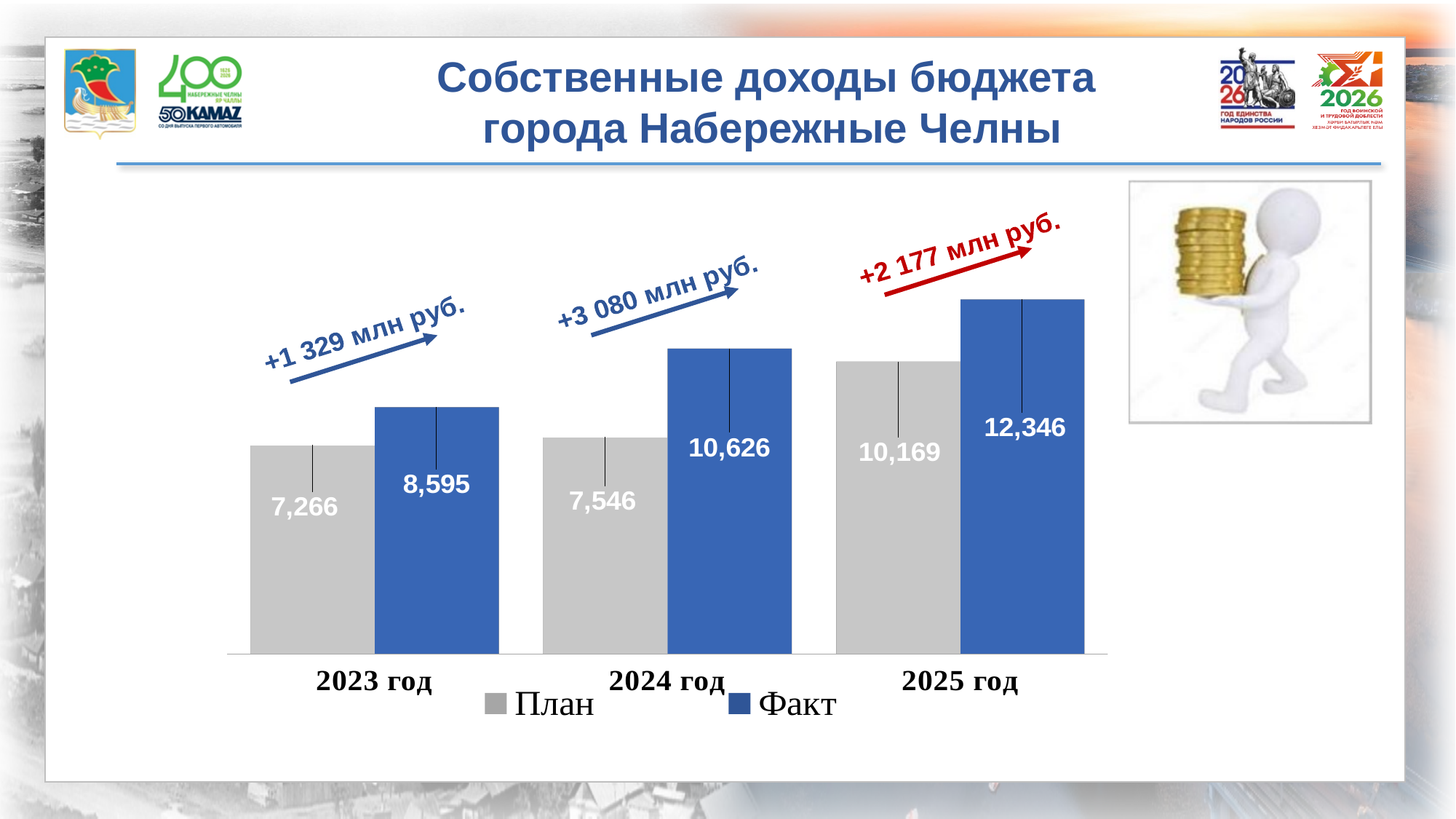
What is the План value for 2025 год? 10,169 Do the Факт values rise or fall from 2023 год to 2025 год? Rise What is the difference between Факт and План for 2024 год? 3,080 What is the Факт value for 2024 год? 10,626 Which is larger for 2023 год: План or Факт? Факт What is the Факт value for 2025 год? 12,346 How many years are shown on the x axis? 3 What is the План value for 2023 год? 7,266 Which year has the lowest План value? 2023 год Which year has the highest Факт value? 2025 год How many series does the legend list? 2 What kind of chart is shown on the slide? Bar chart